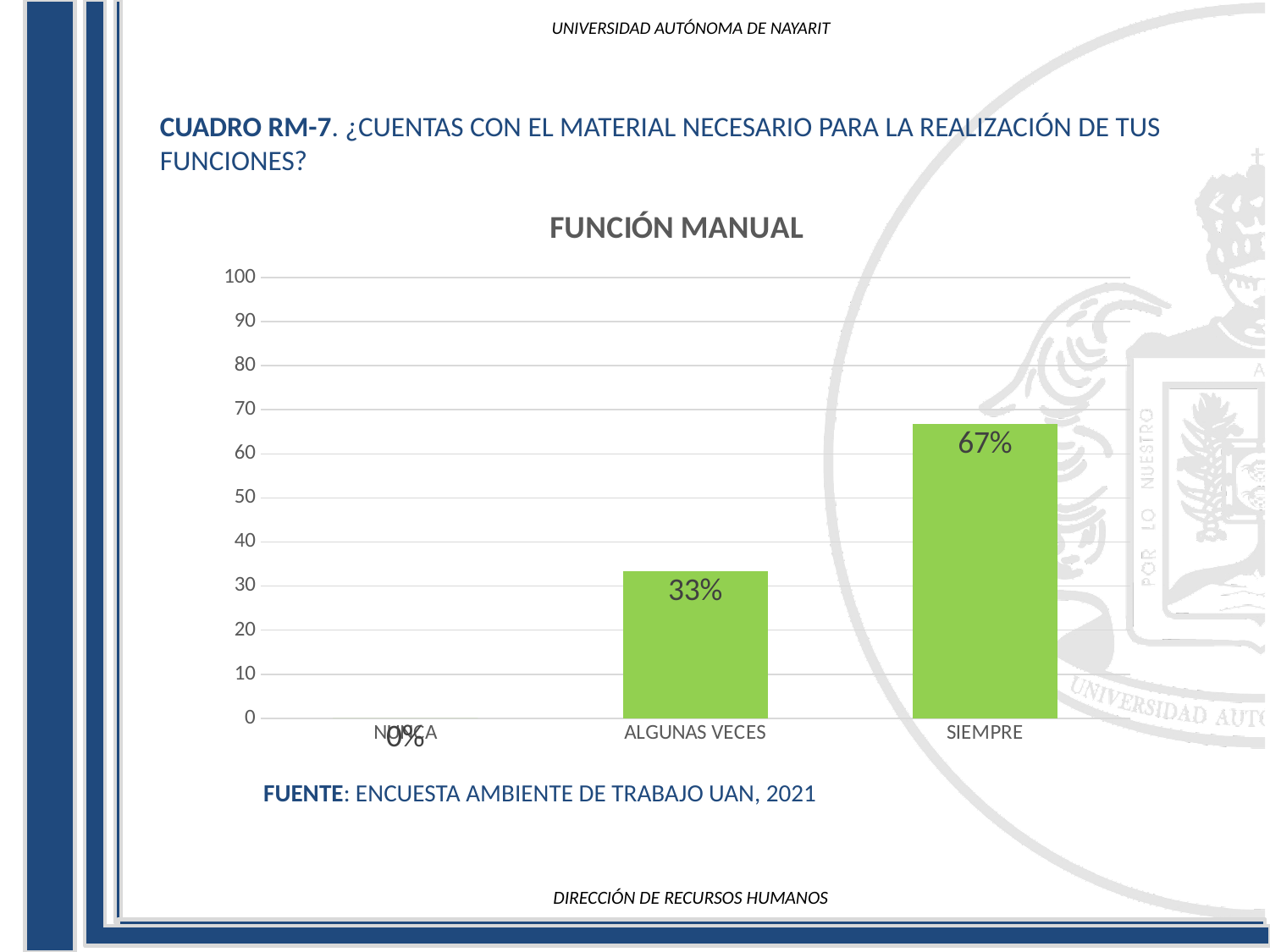
What is the difference between the values for SIEMPRE and ALGUNAS VECES? 34% What is the value for SIEMPRE? 67% What is the title of the chart? FUNCIÓN MANUAL Is the value for SIEMPRE greater or less than 50? greater Which is larger, the value for ALGUNAS VECES or the value for SIEMPRE? SIEMPRE What kind of chart is shown? bar chart Which category has the highest value? SIEMPRE How many categories are shown on the x axis? 3 What is the value for NUNCA? 0% What is the value for ALGUNAS VECES? 33% Is the value for ALGUNAS VECES greater or less than 40? less Which category has the lowest value? NUNCA